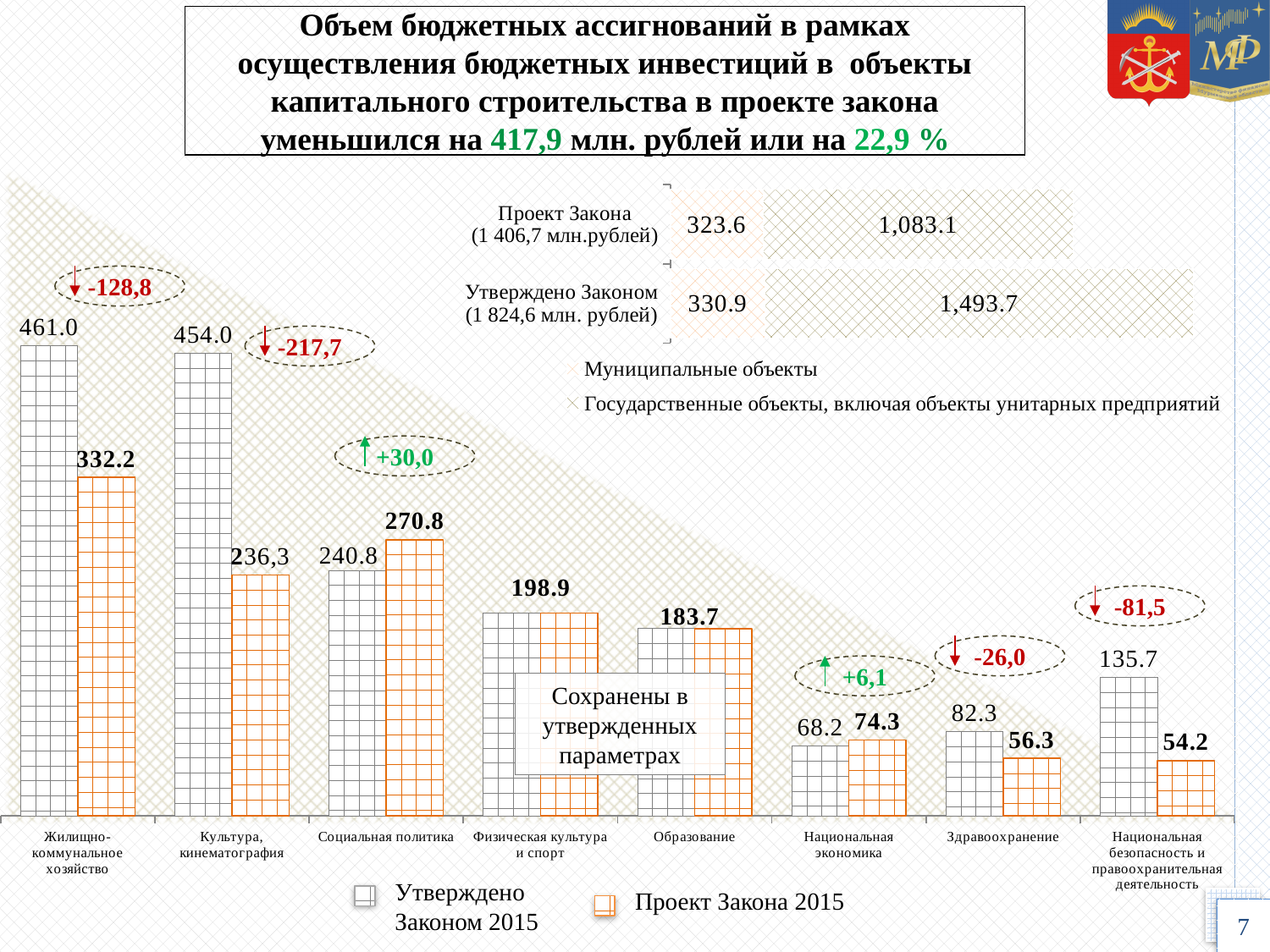
In the bar chart at the bottom of the slide, what is the value for Жилищно-коммунальное хозяйство in the Утверждено Законом 2015 series? 461.0 How many series does the legend of the bar chart at the bottom of the slide list? 2 In the bar chart at the bottom of the slide, what is the value for Социальная политика in the Проект Закона 2015 series? 270.8 What kind of chart is the chart at the top right of the slide? Stacked bar chart How many categories are shown on the x axis of the bar chart at the bottom of the slide? 8 In the bar chart at the bottom of the slide, for Национальная экономика, which series has the larger value: Утверждено Законом 2015 or Проект Закона 2015? Проект Закона 2015 In the stacked bar chart at the top right, what is the value of the Государственные объекты segment for Утверждено Законом? 1,493.7 In the stacked bar chart at the top right, what is the total of the Проект Закона bar (323.6 + 1,083.1)? 1,406.7 In the bar chart at the bottom of the slide, what is the value for Здравоохранение in the Проект Закона 2015 series? 56.3 In the bar chart at the bottom of the slide, which category has the highest value in the Утверждено Законом 2015 series? Жилищно-коммунальное хозяйство In the bar chart at the bottom of the slide, which category has the lowest value in the Проект Закона 2015 series? Национальная безопасность и правоохранительная деятельность In the bar chart at the bottom of the slide, what is the difference between the Утверждено Законом 2015 value (135.7) and the Проект Закона 2015 value (54.2) for Национальная безопасность и правоохранительная деятельность? 81.5